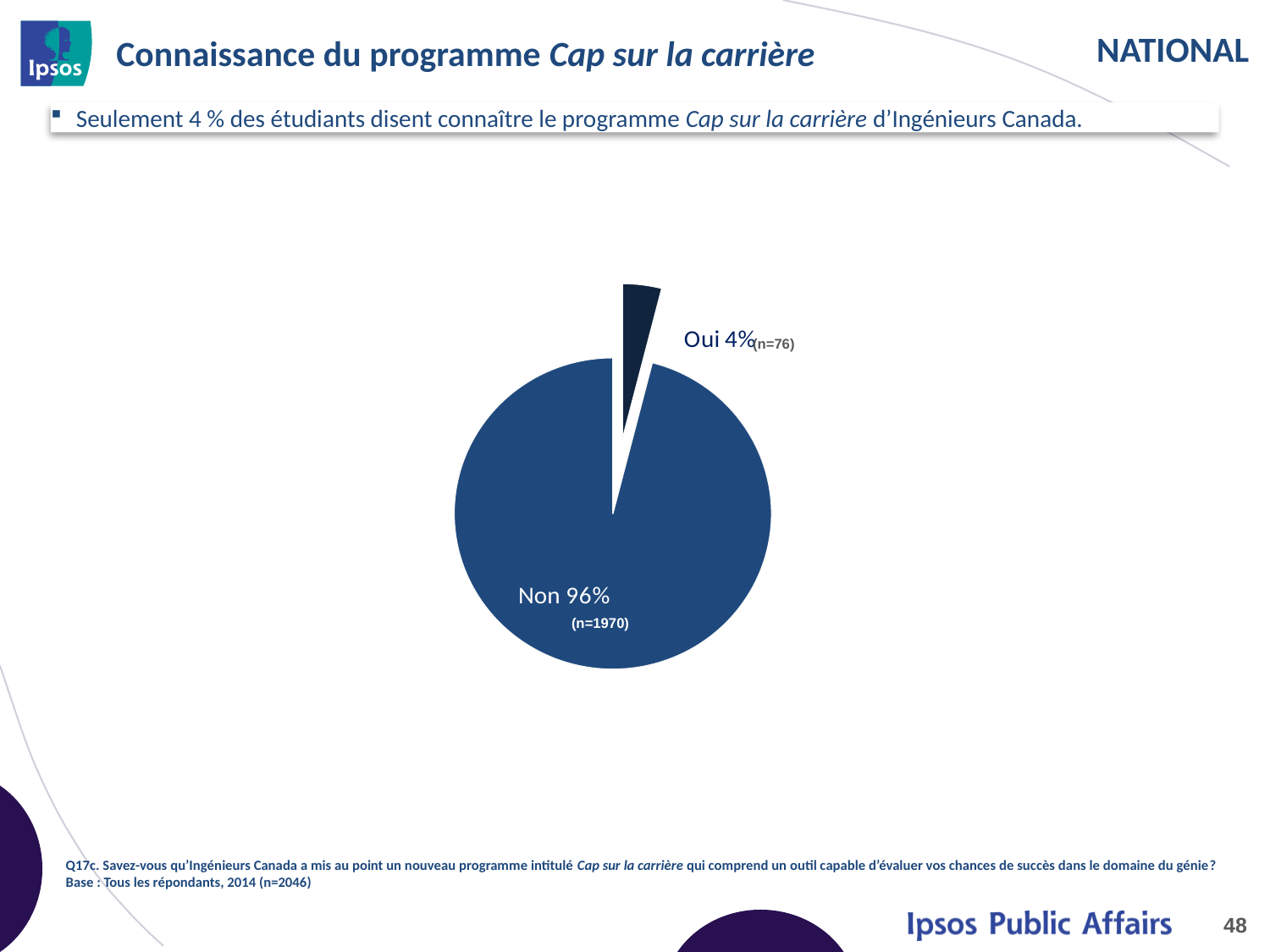
Which slice of the pie is the largest? Non What kind of chart is shown on the slide? pie chart How many slices does the pie chart have? 2 Which slice of the pie is the smallest? Oui What is the title of the slide containing the chart? Connaissance du programme Cap sur la carrière What is the difference in percentage points between the "Non" and "Oui" slices? 92 Which is larger, the "Oui" slice or the "Non" slice? Non What percentage of students answered "Oui"? 4% What percentage of students answered "Non"? 96% What is the sample size (n) shown for the "Non" slice? n=1970 What share of the pie does the "Non" slice represent? 96% What is the sample size (n) shown for the "Oui" slice? n=76